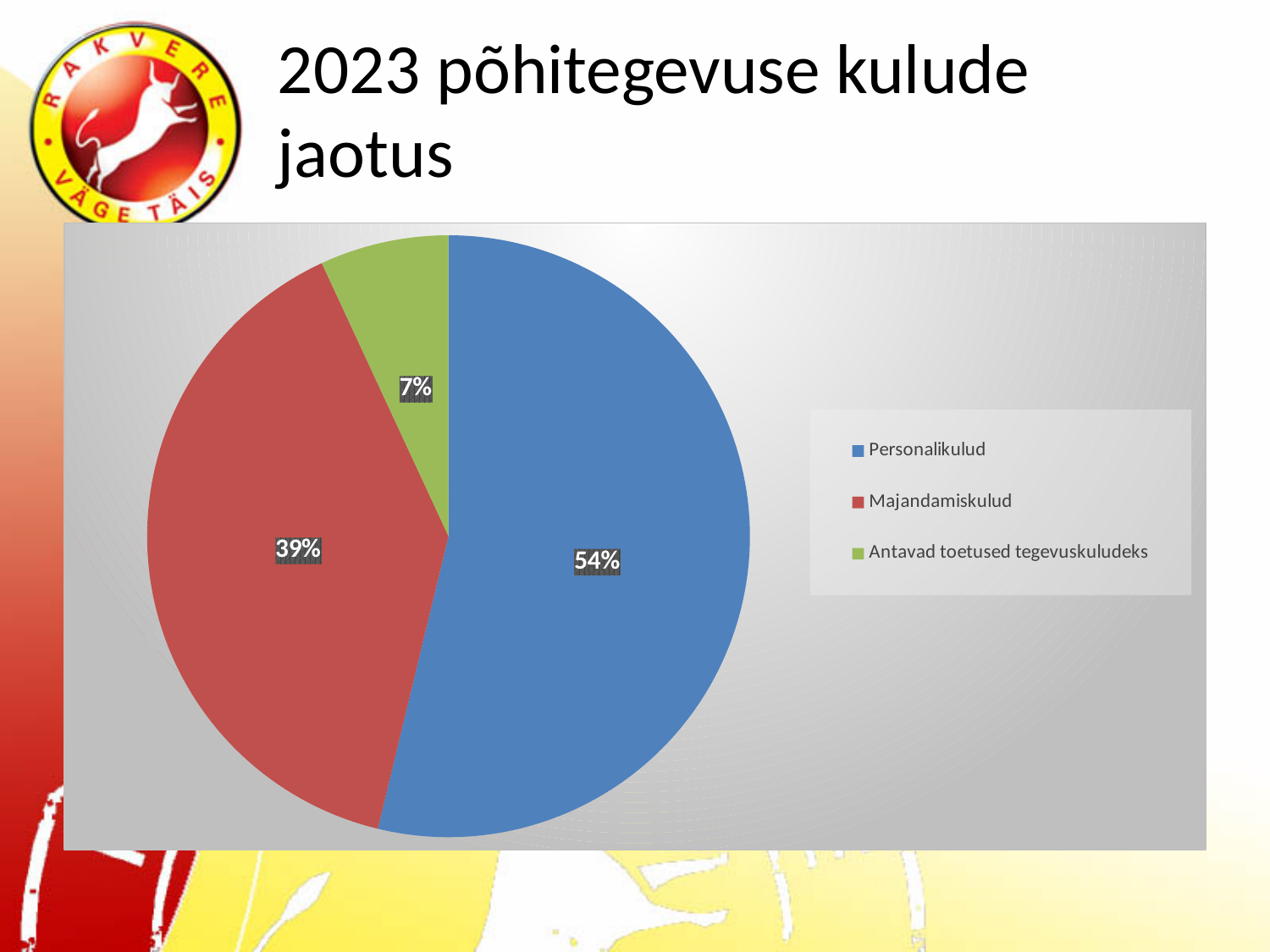
Which category has the largest slice of the pie? Personalikulud What colour is the slice for Majandamiskulud? red What share of the pie does Personalikulud have? 54% What share of the pie does Majandamiskulud have? 39% What is the difference in percentage points between Personalikulud and Majandamiskulud? 15 How many categories does the pie chart have? 3 Which category has the smallest slice of the pie? Antavad toetused tegevuskuludeks What share of the pie does Antavad toetused tegevuskuludeks have? 7% What is the title of the slide containing the chart? 2023 põhitegevuse kulude jaotus What kind of chart is shown on the slide? pie chart What is the difference in percentage points between Majandamiskulud and Antavad toetused tegevuskuludeks? 32 Which is larger, Majandamiskulud or Antavad toetused tegevuskuludeks? Majandamiskulud